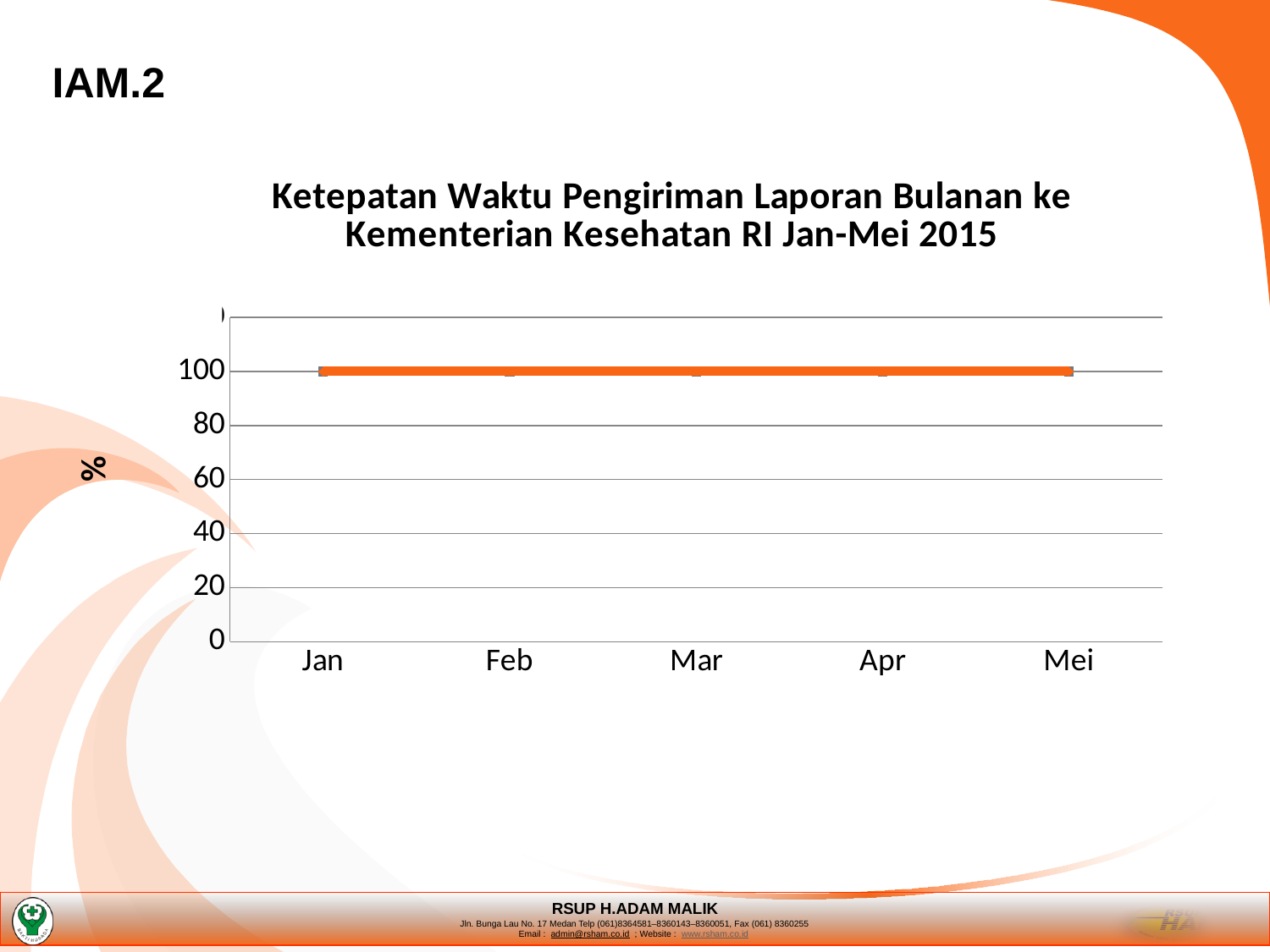
What is the value for Mei? 100 What is the title of the chart? Ketepatan Waktu Pengiriman Laporan Bulanan ke Kementerian Kesehatan RI Jan-Mei 2015 Is the value for Feb greater or less than 80? greater What is the value for Jan? 100 What label is shown on the vertical axis? % Is the value for Apr greater or less than 60? greater Do the values rise, fall, or stay flat from Jan to Mei? stay flat How many months are plotted along the x axis? 5 What is the difference between the values for Jan and Apr? 0 What is the value for Mar? 100 What kind of chart is shown on the slide? line chart Which month is the first category on the x axis? Jan